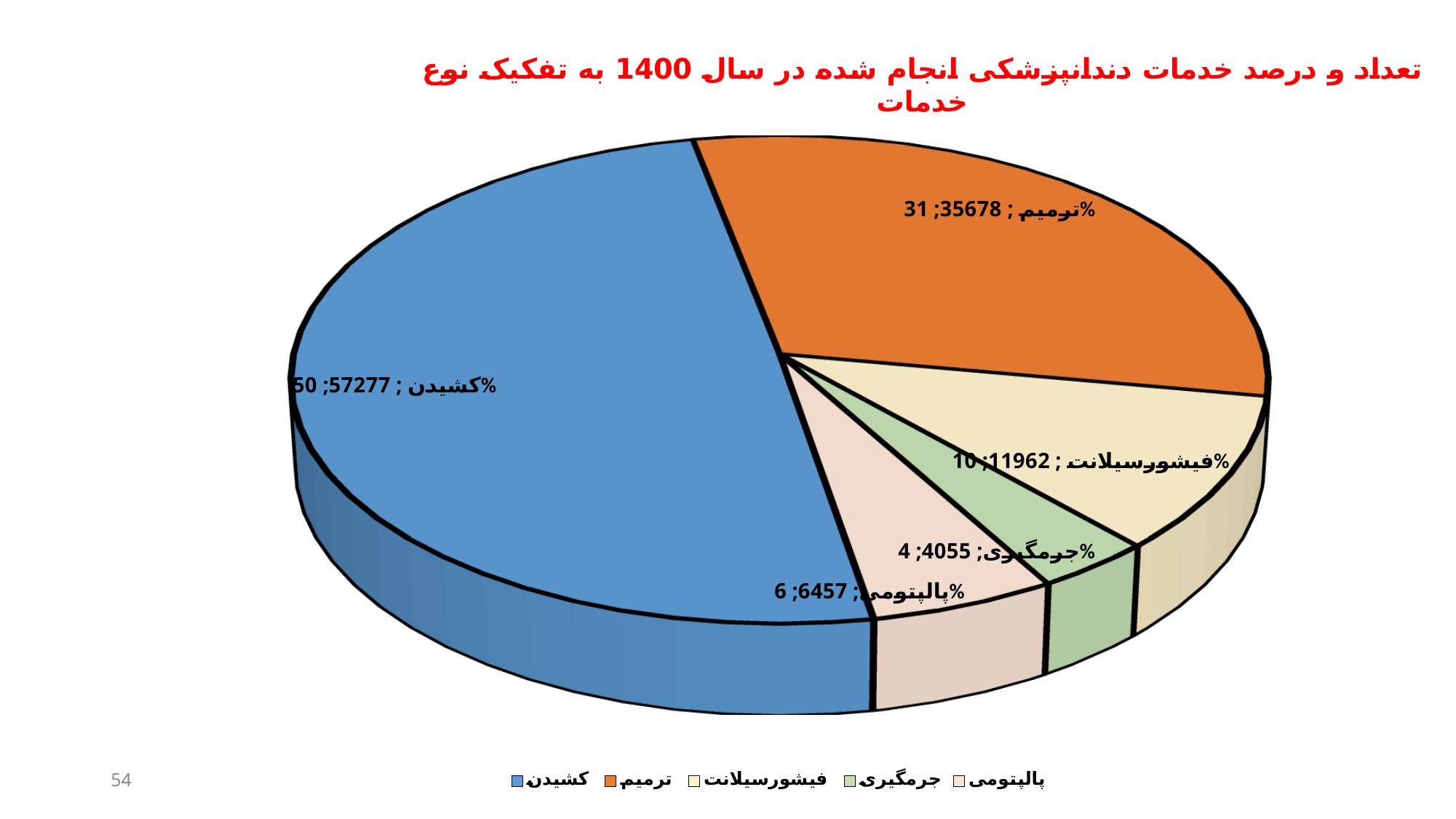
Which category has the largest slice of the pie? کشیدن What percentage is shown for the پالپتومی slice? 6% What count is shown for the کشیدن slice? 57277 Which is larger, the count for پالپتومی or the count for جرمگیری? پالپتومی What kind of chart is shown on the slide? Pie chart How many categories does the pie chart show? 5 Which category has the smallest slice of the pie? جرمگیری What count is shown for the ترمیم slice? 35678 What percentage of the pie does the کشیدن slice represent? 50% What is the difference between the counts for کشیدن and ترمیم? 21599 What count is shown for the جرمگیری slice? 4055 What count is shown for the فیشورسیلانت slice? 11962